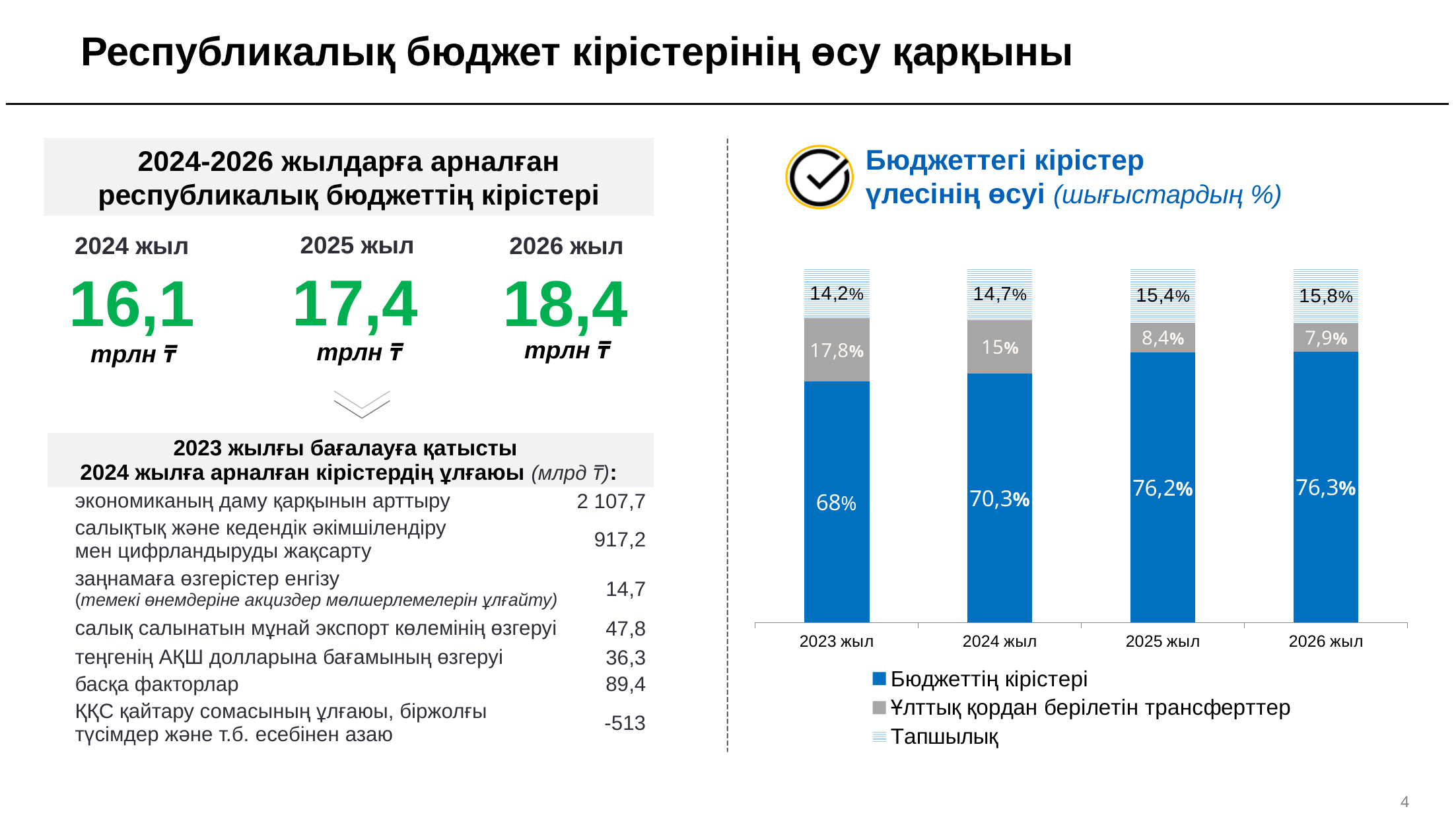
In which year is Бюджеттің кірістері lowest? 2023 жыл Does the value of Бюджеттің кірістері rise or fall from 2023 жыл to 2026 жыл? Rise How many years are shown on the x axis of the chart? 4 What kind of chart is shown on the slide? Stacked bar chart In which year is Ұлттық қордан берілетін трансферттер highest? 2023 жыл Which is larger: Тапшылық in 2024 жыл or Ұлттық қордан берілетін трансферттер in 2024 жыл? Ұлттық қордан берілетін трансферттер What is the total of the stacked bar for 2025 жыл? 100% What is the value of Ұлттық қордан берілетін трансферттер for 2025 жыл? 8,4% What is the value of Бюджеттің кірістері for 2023 жыл? 68% What is the difference between Ұлттық қордан берілетін трансферттер in 2023 жыл and in 2026 жыл? 9,9% How many series does the chart legend list? 3 What is the value of Тапшылық for 2026 жыл? 15,8%